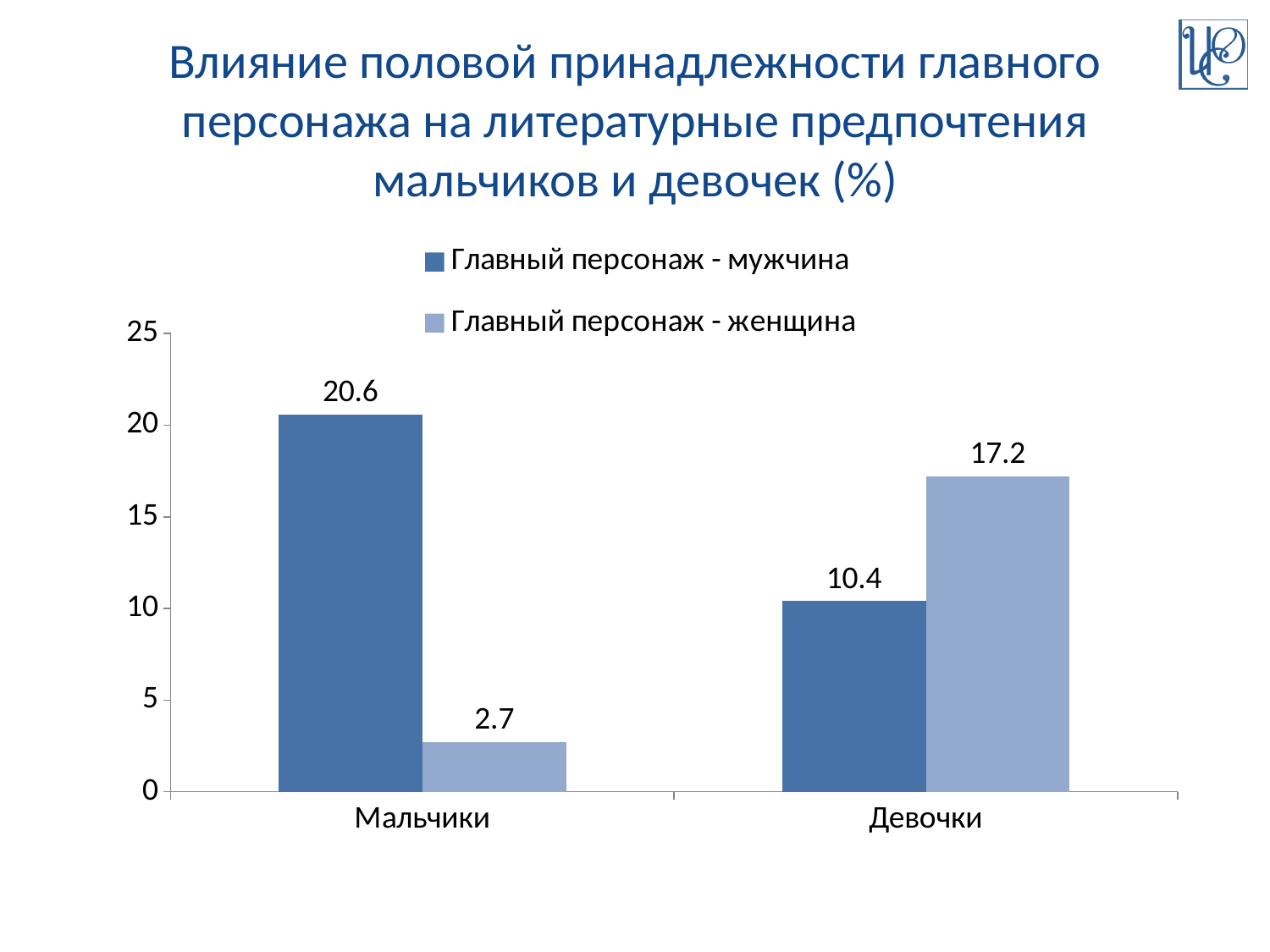
Which is larger for Девочки: 'Главный персонаж - мужчина' or 'Главный персонаж - женщина'? Главный персонаж - женщина Is the value for 'Главный персонаж - мужчина' for Мальчики greater or less than 20? greater How many series does the legend list? 2 What is the value for 'Главный персонаж - мужчина' for Девочки? 10.4 What is the difference between the 'Главный персонаж - мужчина' and 'Главный персонаж - женщина' values for Мальчики? 17.9 How many categories are shown on the x axis? 2 Which category has the highest value for 'Главный персонаж - женщина'? Девочки What kind of chart is shown on the slide? bar chart Which category has the lowest value for 'Главный персонаж - мужчина'? Девочки What is the value for 'Главный персонаж - женщина' for Мальчики? 2.7 What is the value for 'Главный персонаж - мужчина' for Мальчики? 20.6 What is the value for 'Главный персонаж - женщина' for Девочки? 17.2